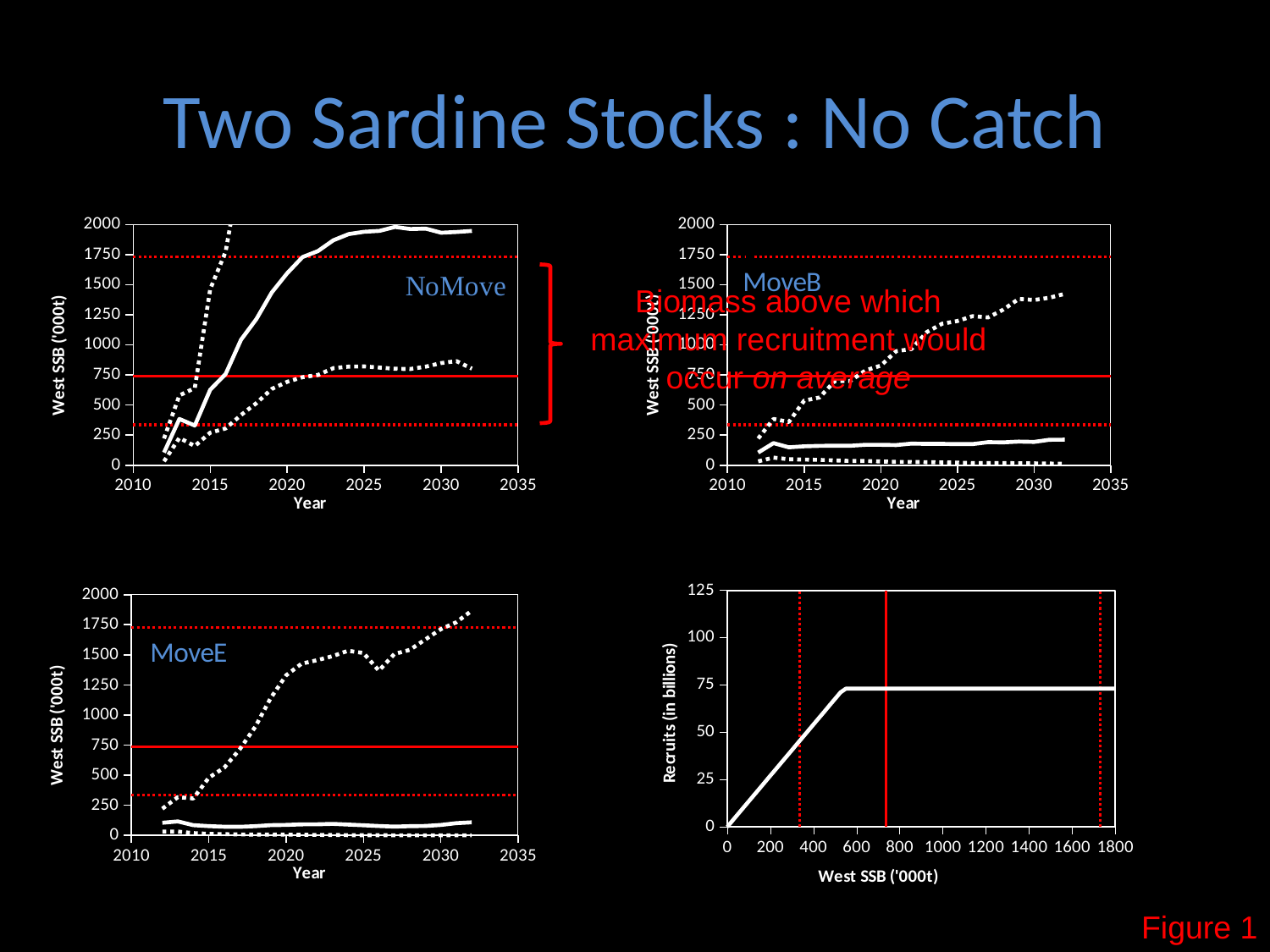
What is the y-axis label of the bottom-right chart? Recruits (in billions) In the bottom-right chart, is the plateau value of the recruits line greater or less than 50? greater In the MoveB chart, is the value of the solid white line in 2030 greater or less than 500? less In the MoveE chart, is the value of the upper dotted white line in 2032 greater or less than 1750? greater What kind of chart is the NoMove chart at the top left of the slide? line chart What is the x-axis label of the NoMove chart? Year In the NoMove chart, does the solid white line rise or fall between 2015 and 2025? rise How many charts are shown on the slide? 4